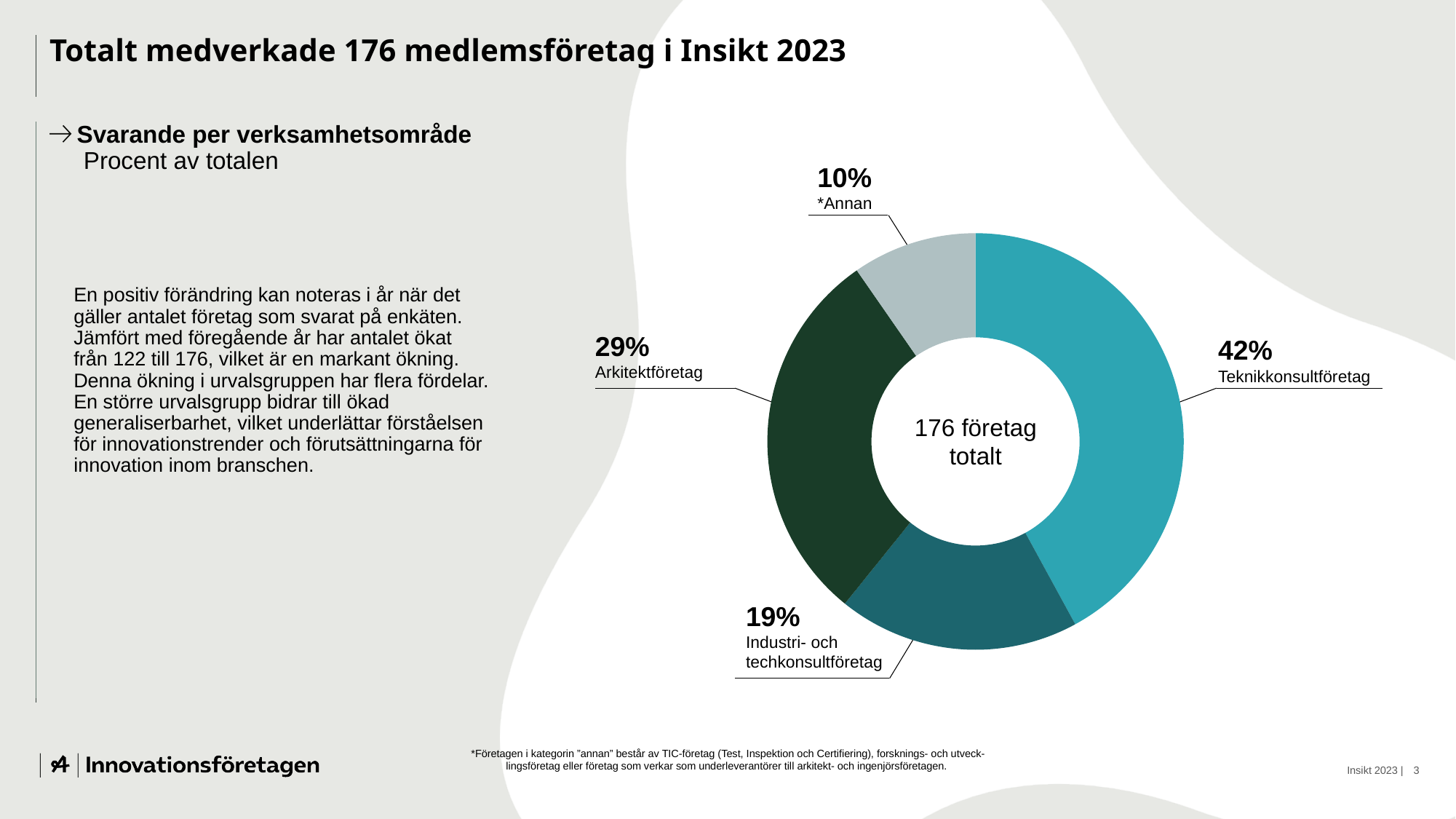
Which category has the largest share in the chart? Teknikkonsultföretag What percentage is shown for the *Annan category? 10% What share of the total do Teknikkonsultföretag represent in the donut chart? 42% Which category has the smallest share in the chart? *Annan What is the combined share of Arkitektföretag and *Annan? 39% What kind of chart is shown on the slide? Donut (pie) chart What is the difference in percentage points between Teknikkonsultföretag and Arkitektföretag? 13 Which is larger, the share for Arkitektföretag or the share for Industri- och techkonsultföretag? Arkitektföretag How many categories are shown in the chart? 4 What percentage is shown for Industri- och techkonsultföretag? 19% What text is shown in the centre of the donut chart? 176 företag totalt What percentage is shown for Arkitektföretag? 29%